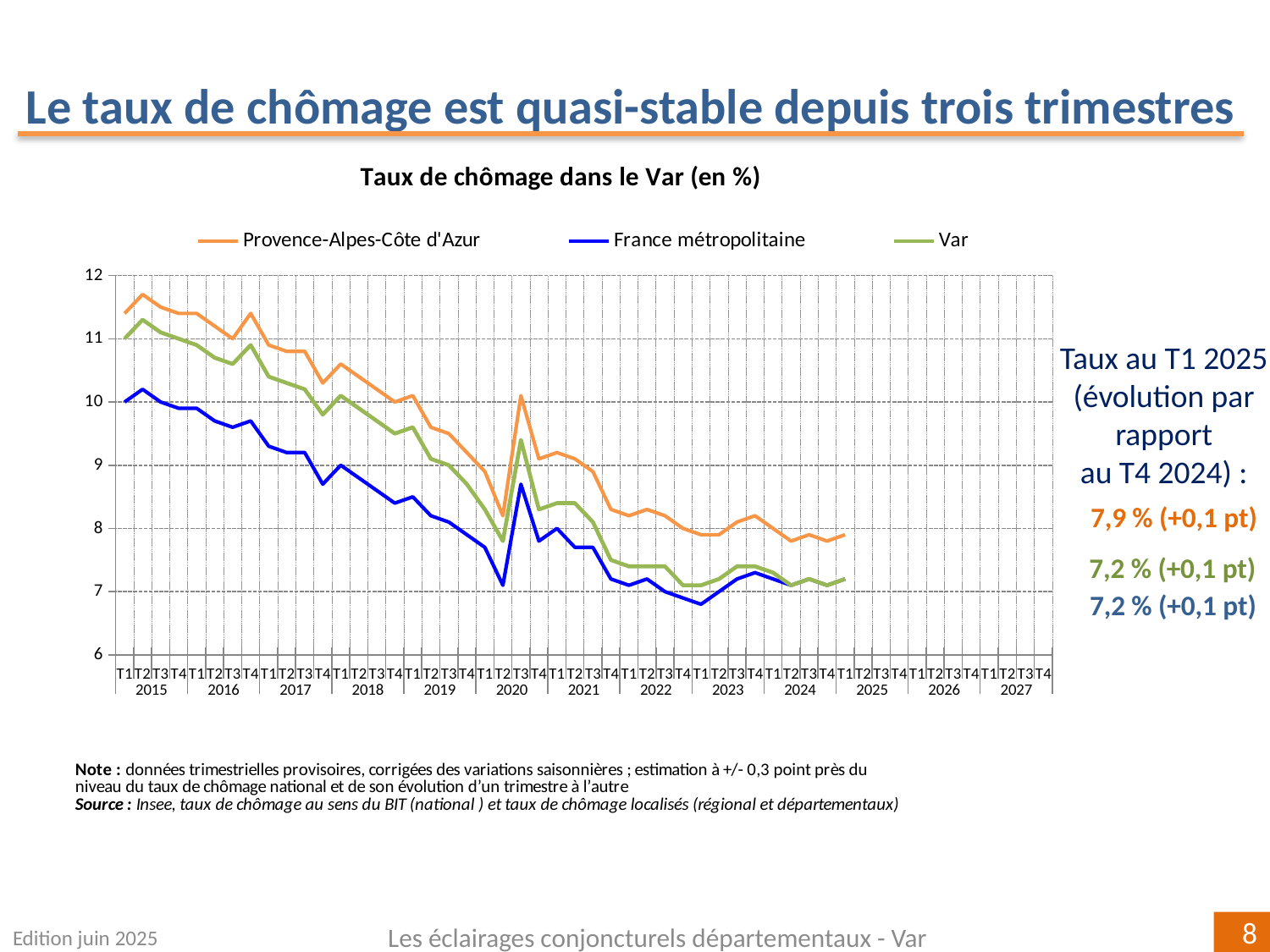
What is the unemployment rate for Var at T1 2025? 7,2 % By how much did the Var rate change at T1 2025 compared with T4 2024? +0,1 pt Overall, do the unemployment rates rise or fall between 2015 and 2025? fall What kind of chart is shown on the slide? line chart Is the value for France métropolitaine at T2 2020 greater or less than 8? less What is the difference between the Provence-Alpes-Côte d'Azur rate and the Var rate at T1 2025? 0,7 points What is the unemployment rate for France métropolitaine at T1 2025? 7,2 % Which series has the highest value at T1 2025? Provence-Alpes-Côte d'Azur At T1 2025, which is higher: the rate for Provence-Alpes-Côte d'Azur or for France métropolitaine? Provence-Alpes-Côte d'Azur Is the value for Provence-Alpes-Côte d'Azur at T1 2015 greater or less than 11? greater What is the unemployment rate for Provence-Alpes-Côte d'Azur at T1 2025? 7,9 % How many series does the legend list? 3